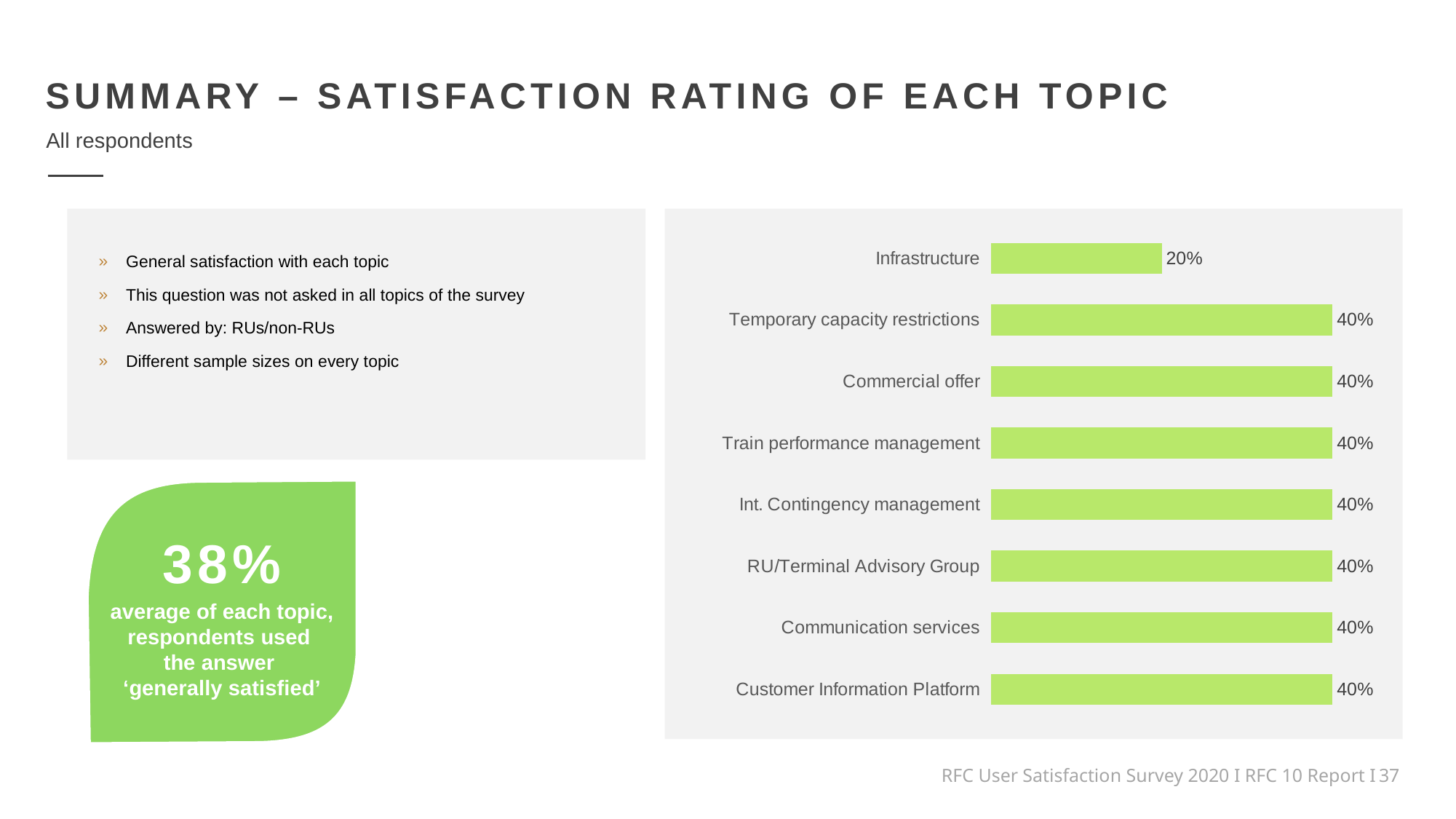
Which category has the lowest value? Infrastructure What is the difference between the values for Temporary capacity restrictions and Infrastructure? 20% How many categories have a value of 40%? 7 What is the value for Commercial offer? 40% What colour are the bars in the chart? Green What is the value for Customer Information Platform? 40% What is the value for Infrastructure? 20% How many categories are shown in the chart? 8 Which category is listed first (at the top) in the chart? Infrastructure What kind of chart is shown on the slide? Bar chart What is the value for Int. Contingency management? 40% Which is larger, the value for Infrastructure or the value for Communication services? Communication services